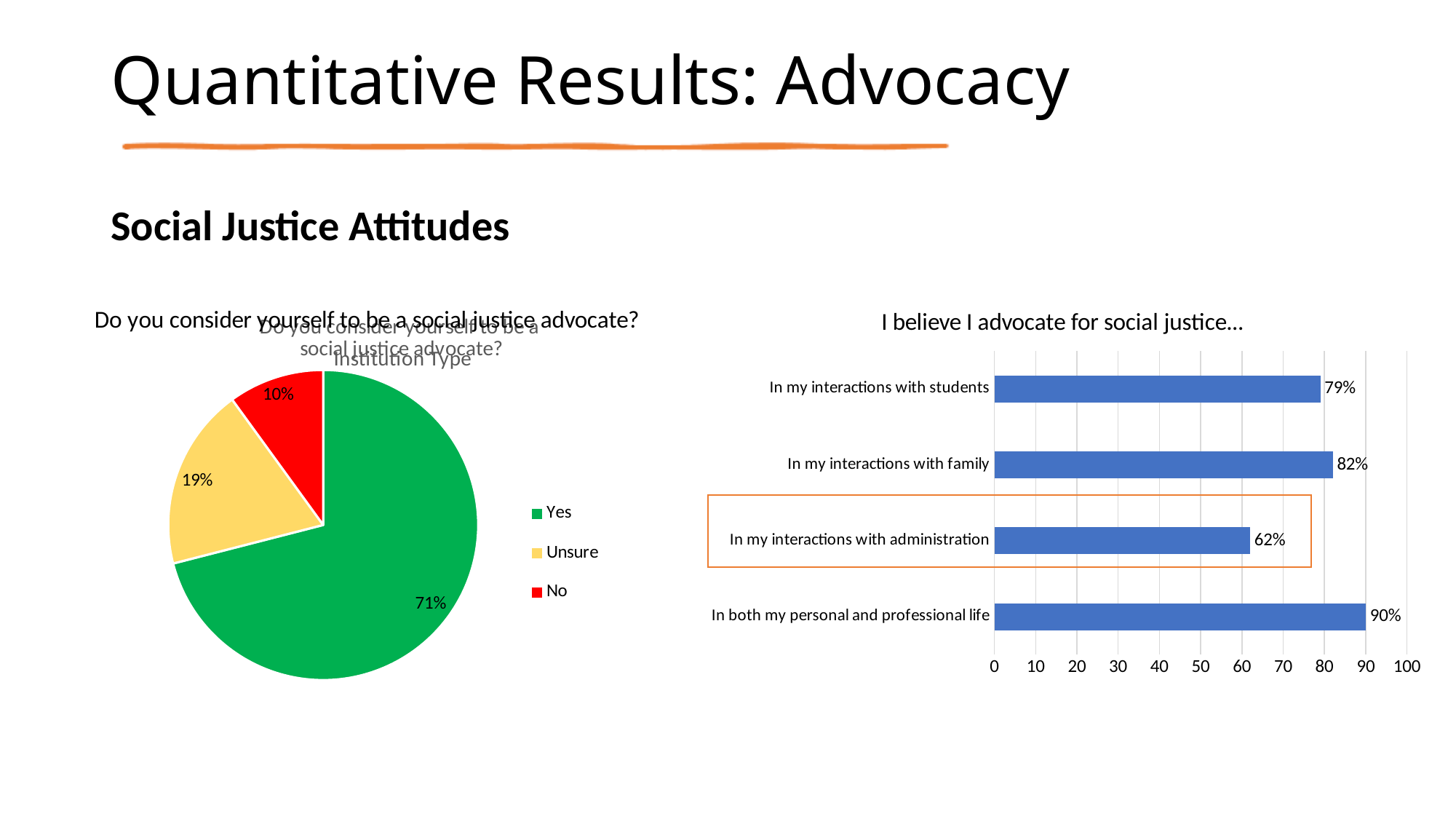
In the pie chart on the left, what percentage of respondents answered Yes? 71% In the pie chart on the left, which response has the smallest share? No In the pie chart on the left, what percentage of respondents answered No? 10% In the chart titled 'I believe I advocate for social justice...', how many categories are plotted? 4 What kind of chart is the one titled 'I believe I advocate for social justice...'? Bar chart In the chart titled 'I believe I advocate for social justice...', what is the value for 'In both my personal and professional life'? 90% In the chart titled 'I believe I advocate for social justice...', what is the difference between the values for 'In my interactions with family' and 'In my interactions with students'? 3% In the chart titled 'I believe I advocate for social justice...', what is the value for 'In my interactions with administration'? 62% In the pie chart on the left, what colour is the Yes slice? Green In the pie chart on the left, what percentage of respondents answered Unsure? 19% In the chart titled 'I believe I advocate for social justice...', which category has the highest value? In both my personal and professional life In the pie chart on the left, how many entries does the legend list? 3